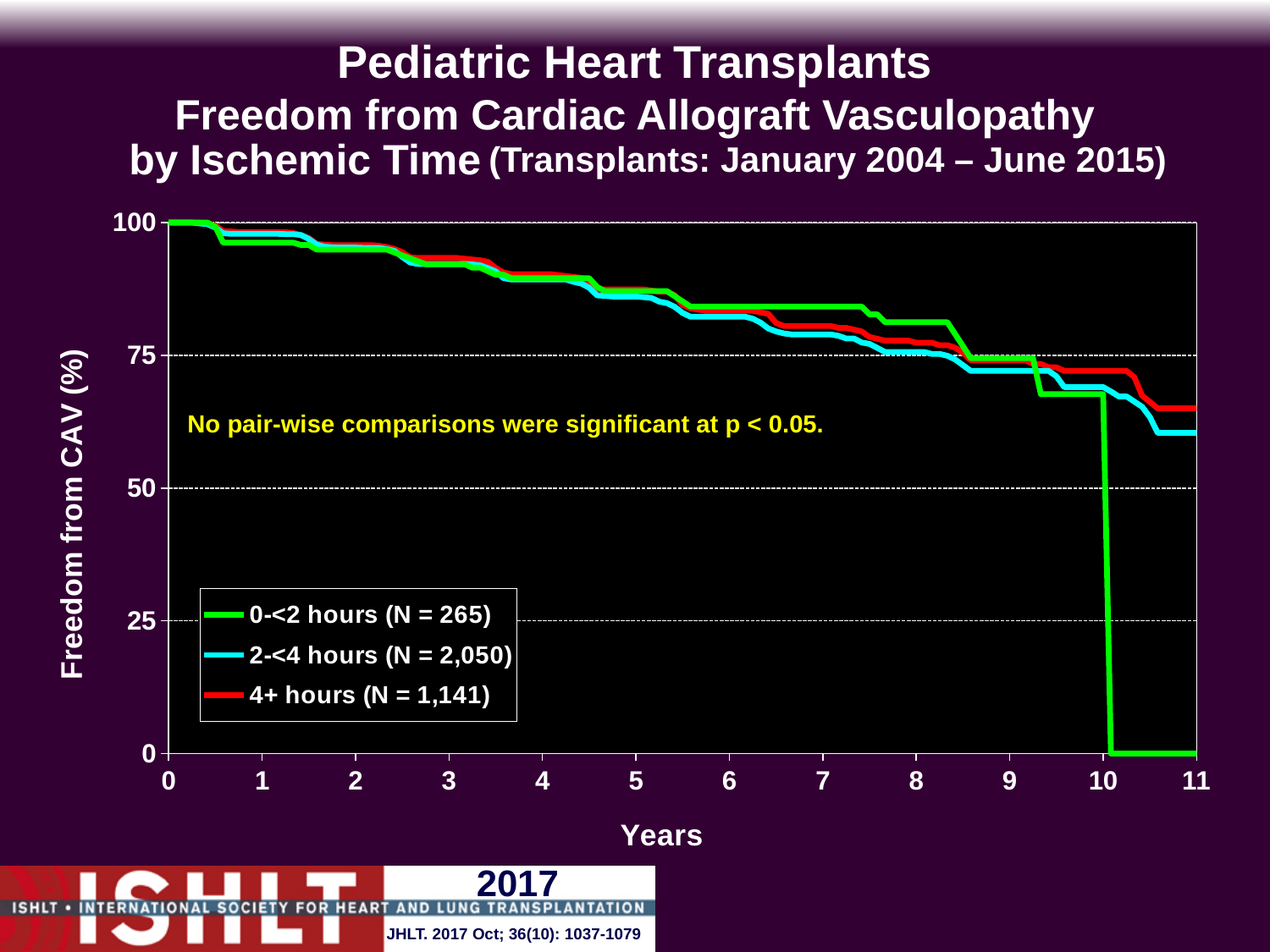
What kind of chart is shown on the slide? line chart What is the N for the 4+ hours group shown in the legend? 1,141 What colour is the line for the 4+ hours group? red How many series does the legend list? 3 What is the N for the 0-<2 hours group shown in the legend? 265 Do the freedom from CAV curves rise or fall as years increase? fall Which ischemic time group has the largest N in the legend? 2-<4 hours What is the N for the 2-<4 hours group shown in the legend? 2,050 Is the freedom from CAV value for the 2-<4 hours group at 10 years greater or less than 75? less Is the freedom from CAV value for the 2-<4 hours group at 11 years greater or less than 50? greater Is the freedom from CAV value for the 4+ hours group at 5 years greater or less than 75? greater